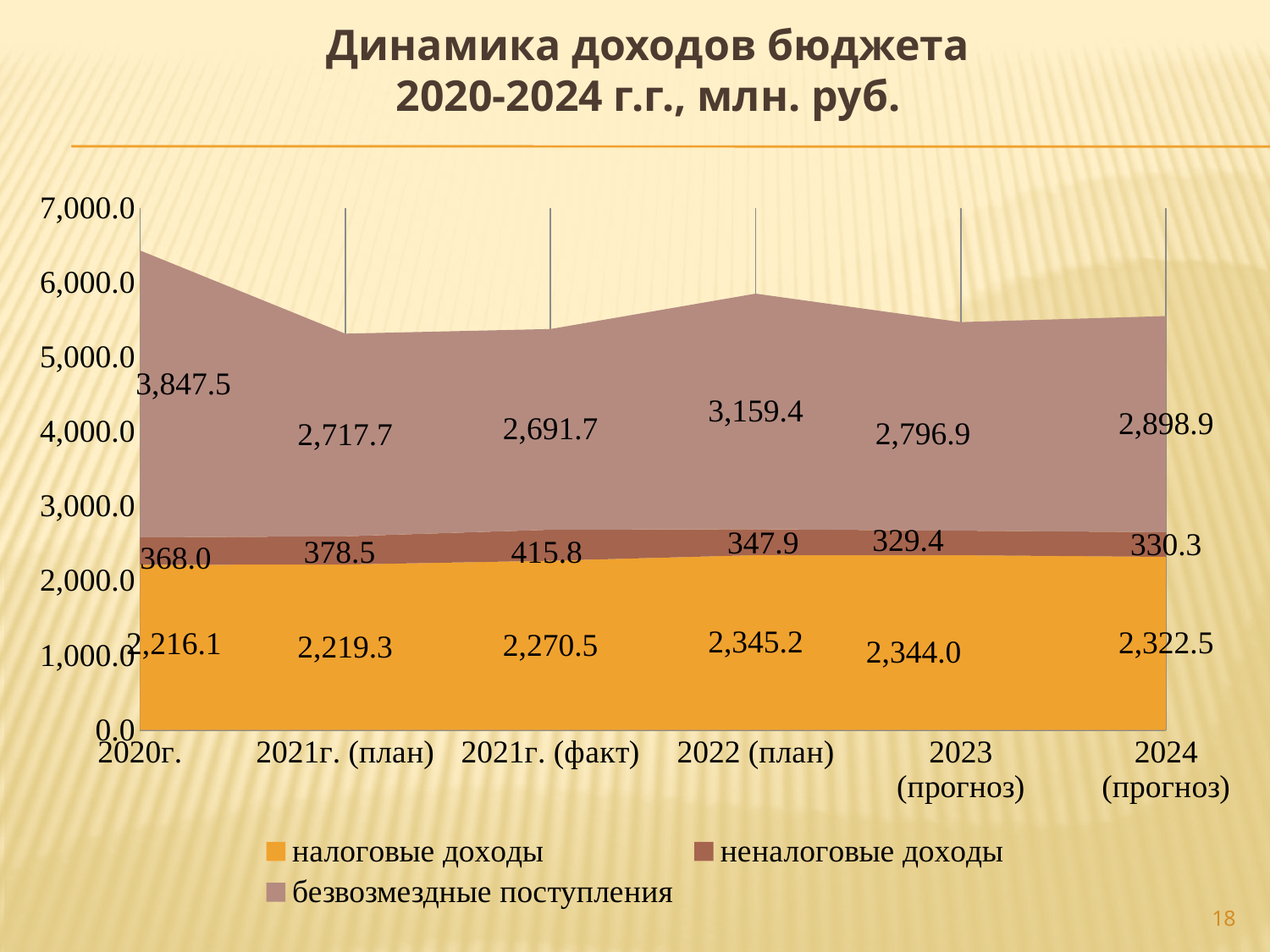
Which category has the highest value for безвозмездные поступления? 2020г. Which is larger: налоговые доходы in 2022 (план) or in 2024 (прогноз)? 2022 (план) What is the total of all three series for 2020г.? 6,431.6 How many series does the legend list? 3 Which category has the lowest value for неналоговые доходы? 2023 (прогноз) What kind of chart is shown on the slide? Stacked area chart What is the value of налоговые доходы for 2020г.? 2,216.1 What is the value of безвозмездные поступления for 2022 (план)? 3,159.4 Which series is shown in orange? налоговые доходы What is the difference between безвозмездные поступления in 2020г. and in 2021г. (план)? 1,129.8 How many categories are shown on the x axis? 6 What is the value of неналоговые доходы for 2021г. (факт)? 415.8